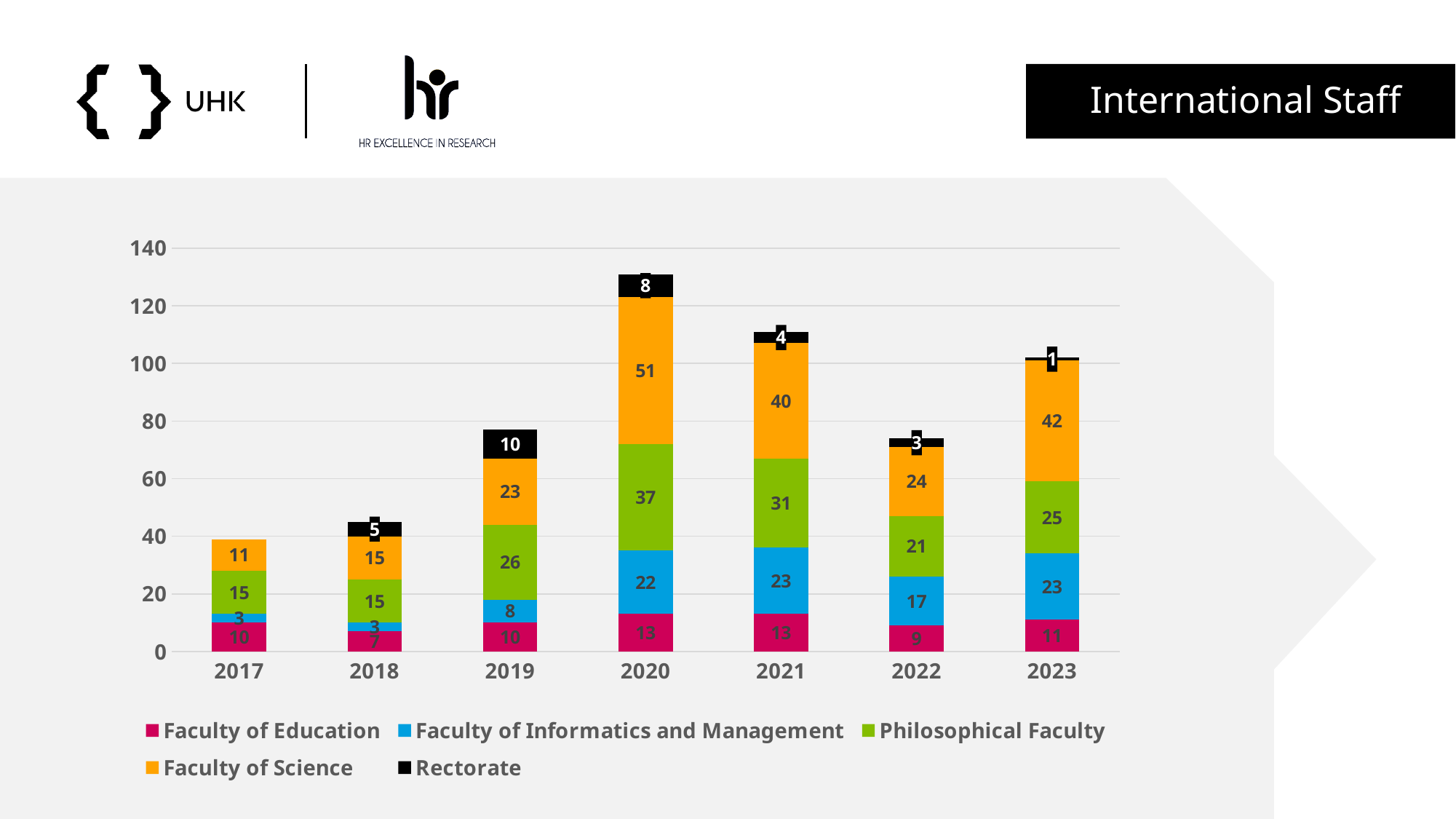
How many years are shown on the x axis? 7 What is the difference between the Faculty of Science values for 2020 and 2021? 11 Which year has the shortest stacked bar? 2017 What is the value for Rectorate in 2019? 10 Which is larger, the Philosophical Faculty value in 2020 or in 2021? 2020 How many series does the legend list? 5 What is the value for Faculty of Informatics and Management in 2022? 17 What kind of chart is shown on the slide? stacked bar chart Is the total height of the 2021 bar greater or less than 100? greater Which year has the tallest stacked bar? 2020 What is the value for Faculty of Science in 2020? 51 What is the total of the stacked bar for 2020? 131